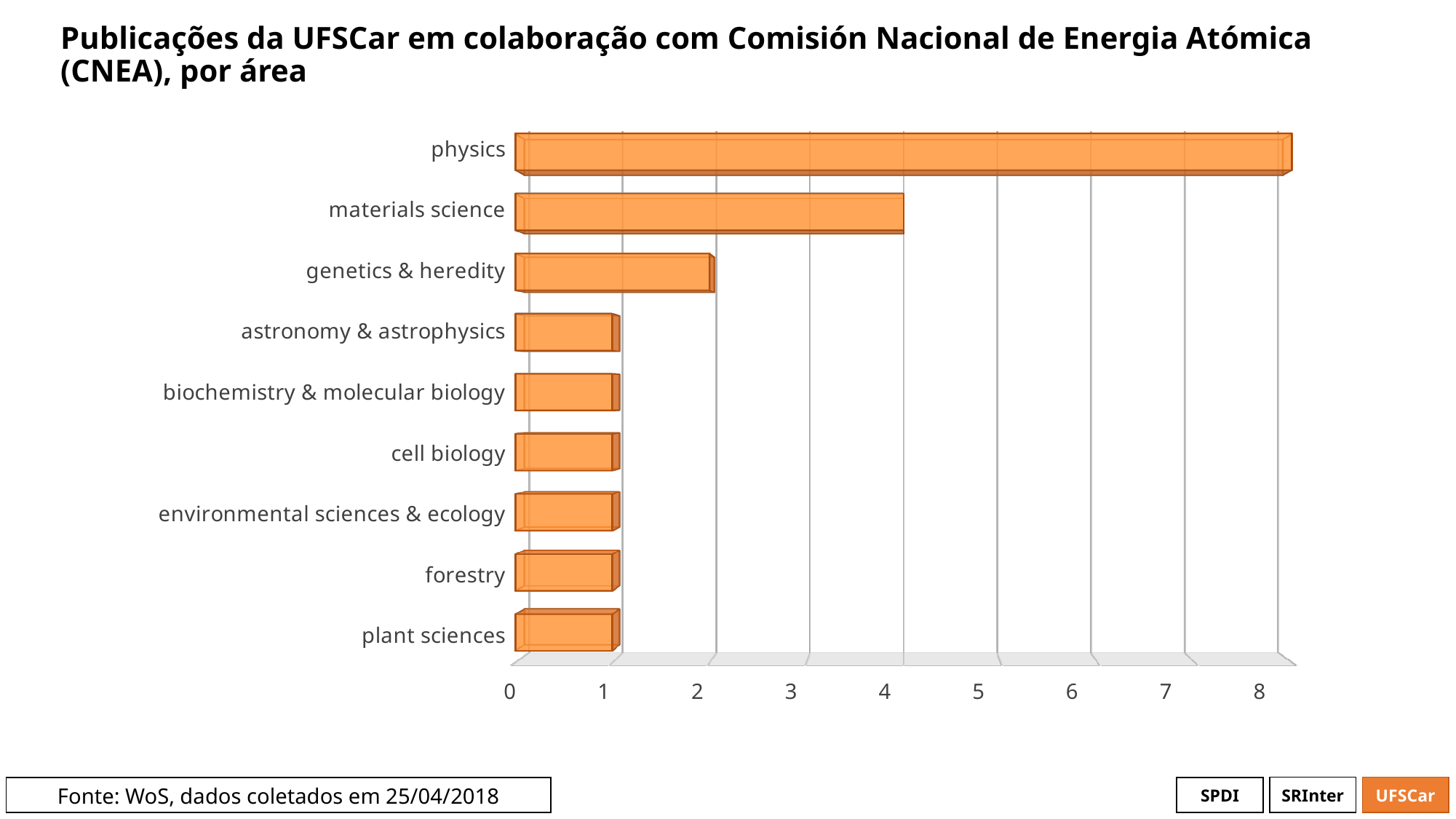
What is the difference between the values for physics and materials science? 4 Which is larger, the value for materials science or the value for genetics & heredity? materials science Is the value for physics greater or less than 7? greater What is the value for materials science? 4 What is the value for physics? 8 Is the value for materials science greater or less than 5? less What kind of chart is shown on the slide? bar chart What is the value for genetics & heredity? 2 How many research areas are shown in the chart? 9 What is the highest value shown on the horizontal axis? 8 What is the value for forestry? 1 Which area has the highest number of publications? physics